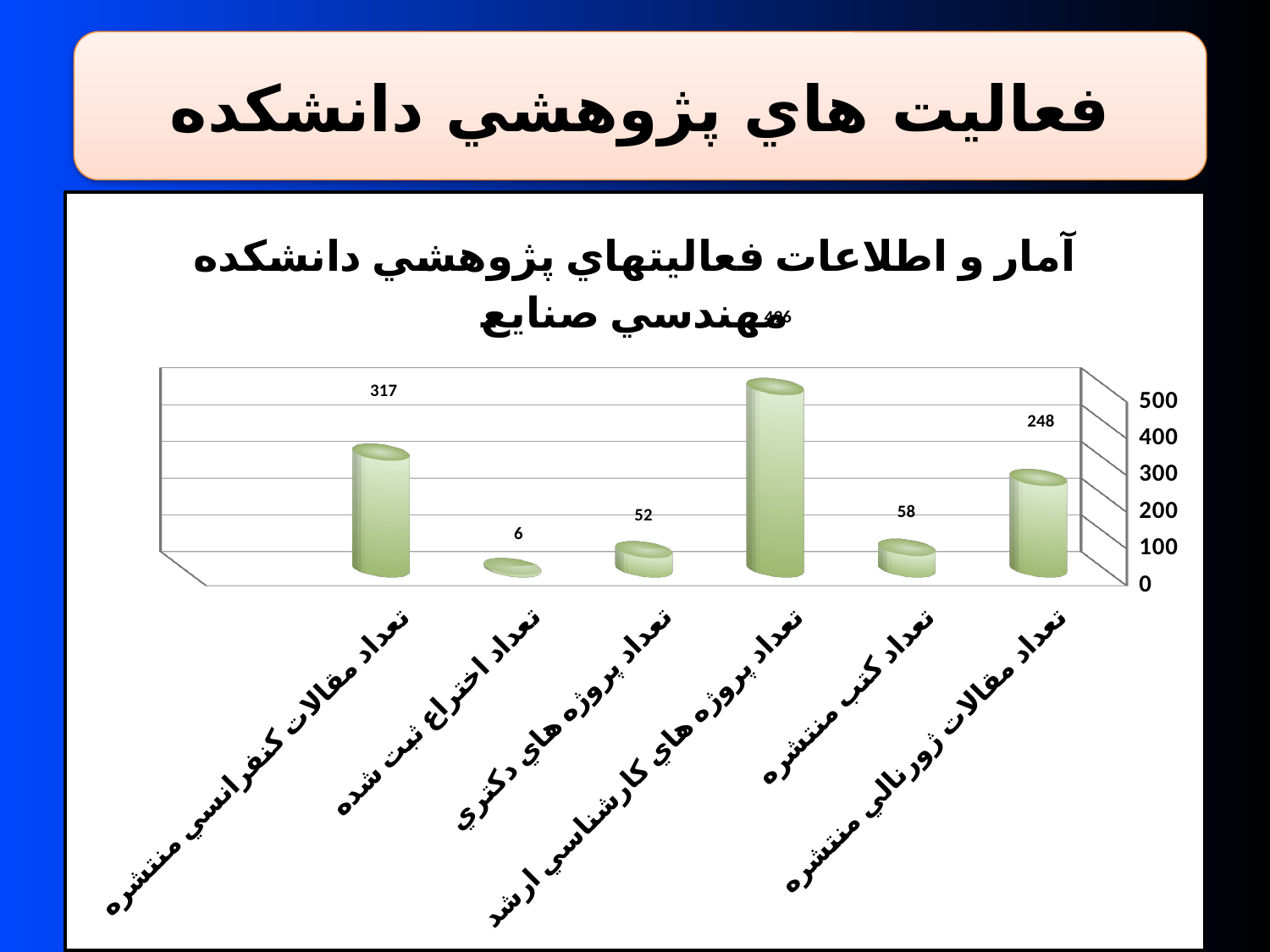
Is the value for تعداد پروژه های کارشناسی ارشد greater or less than 400? greater Which category has the highest value? تعداد پروژه های کارشناسی ارشد What is the value for تعداد مقالات ژورنالی منتشره? 248 What is the value for تعداد مقالات کنفرانسی منتشره? 317 What is the value for تعداد اختراع ثبت شده? 6 Which is larger, the value for تعداد کتب منتشره or the value for تعداد پروژه های دکتری? تعداد کتب منتشره Which category has the lowest value? تعداد اختراع ثبت شده What is the difference between the values for تعداد مقالات کنفرانسی منتشره and تعداد مقالات ژورنالی منتشره? 69 How many categories are shown in the chart? 6 What is the value for تعداد پروژه های دکتری? 52 What kind of chart is shown on the slide? bar chart What is the value for تعداد کتب منتشره? 58